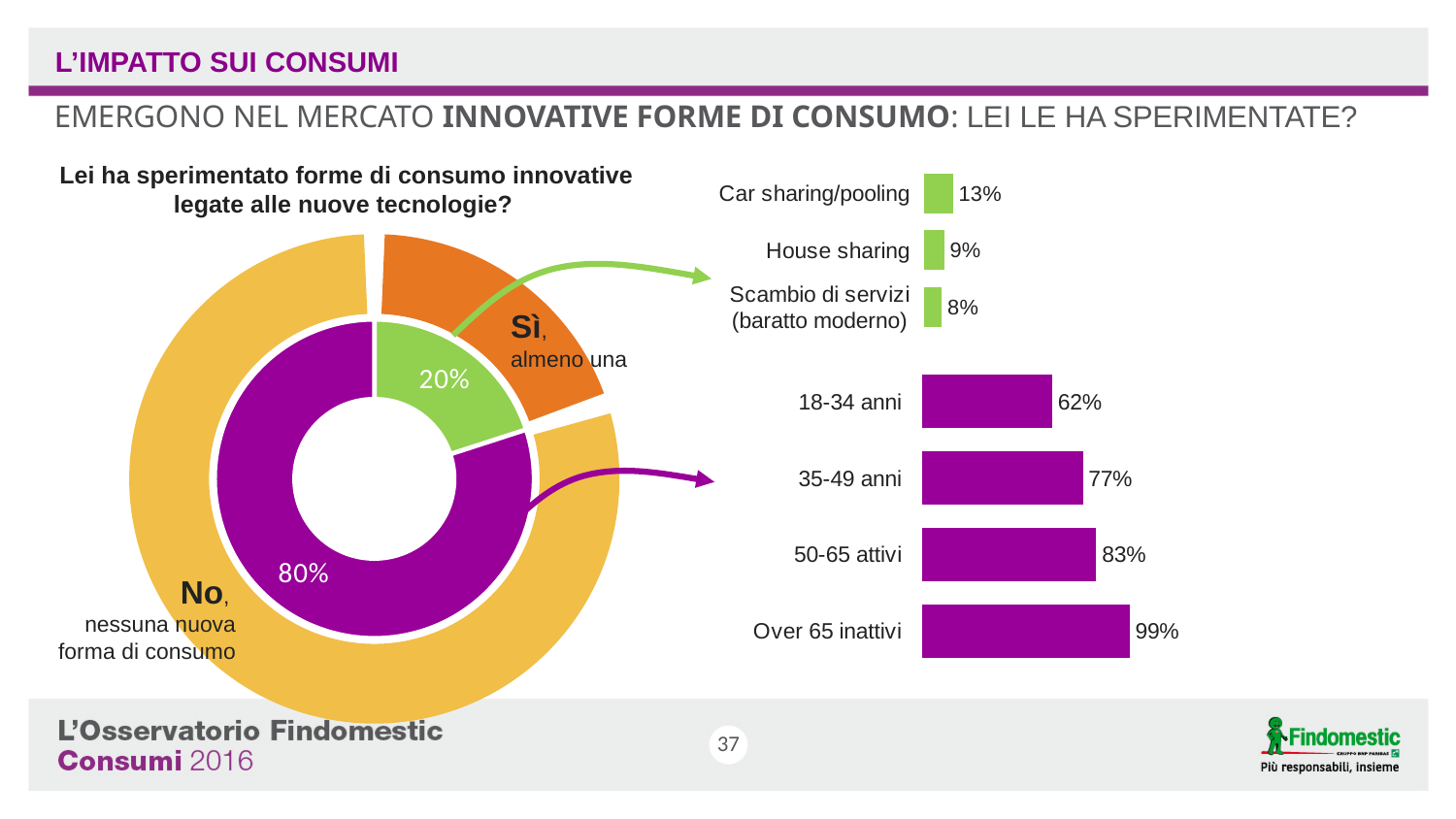
In the donut chart on the left, what share of respondents answered "Sì, almeno una"? 20% In the green bar chart at the top right, how many categories are shown? 3 In the purple bar chart at the bottom right, what is the difference between Over 65 inattivi and 50-65 attivi? 16% In the donut chart on the left, what is the difference between the No share and the Sì share? 60% In the purple bar chart at the bottom right, which age group has the lowest value? 18-34 anni What kind of chart is used for the age groups at the bottom right of the slide? Bar chart In the donut chart on the left, which answer has the larger share, Sì or No? No In the green bar chart at the top right, what is the value for Car sharing/pooling? 13% In the green bar chart at the top right, what is the value for Scambio di servizi (baratto moderno)? 8% In the purple bar chart at the bottom right, what is the value for 35-49 anni? 77% In the donut chart on the left, what share of respondents answered "No, nessuna nuova forma di consumo"? 80% In the green bar chart at the top right, which category has the highest value? Car sharing/pooling